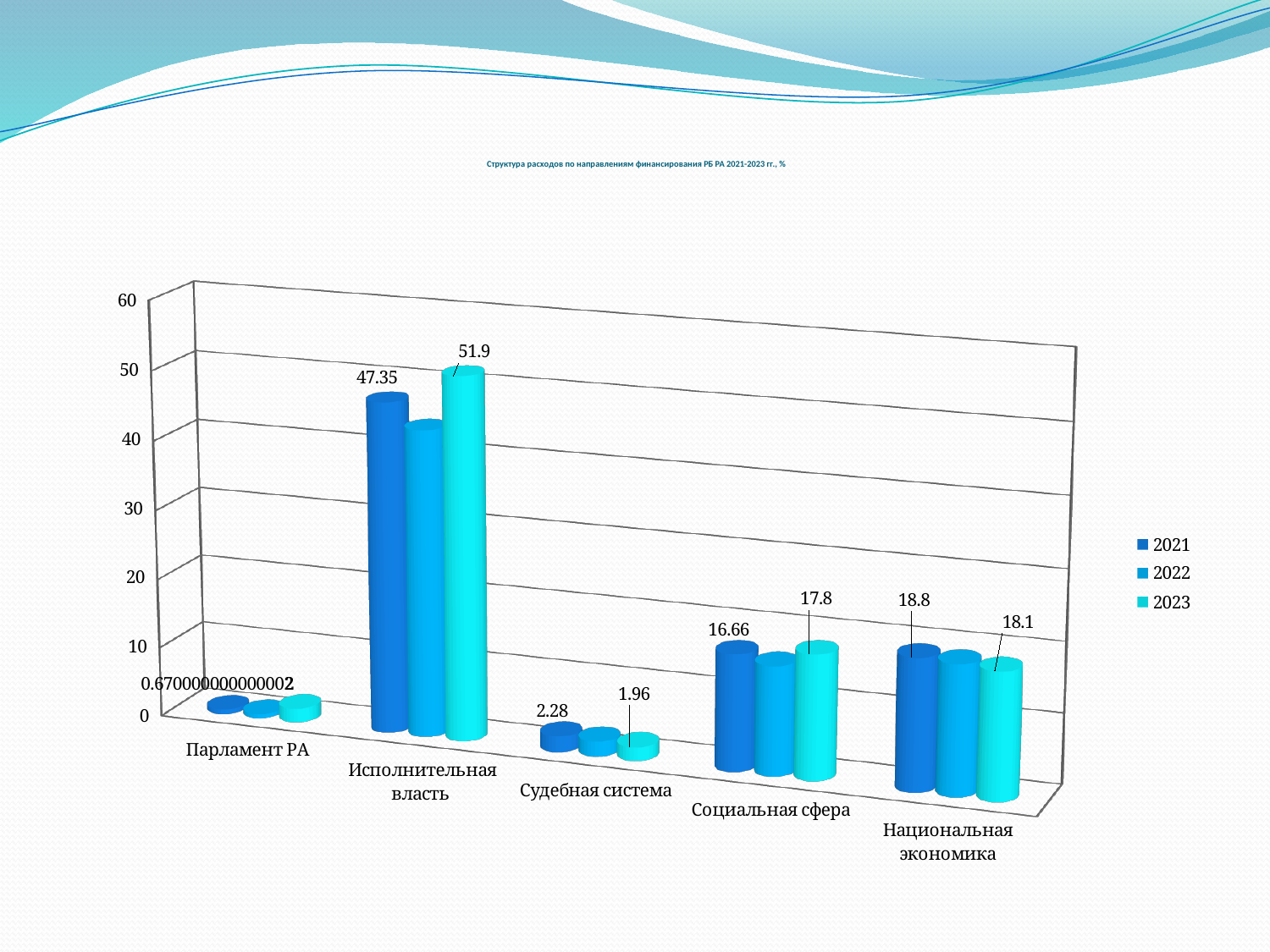
What is the value for Национальная экономика in 2023? 18.1 What is the value for Судебная система in 2023? 1.96 What is the value for Социальная сфера in 2021? 16.66 What is the difference between the 2023 and 2021 values for Исполнительная власть? 4.55 What is the value for Исполнительная власть in 2023? 51.9 What is the value for Исполнительная власть in 2021? 47.35 Is the 2022 value for Исполнительная власть greater or less than 30? greater What type of chart is shown on the slide? Bar chart How many series does the legend list? 3 Which is larger for Национальная экономика: the 2021 value or the 2023 value? 2021 Which category has the lowest value in 2021? Парламент РА Which category has the highest value in 2023? Исполнительная власть